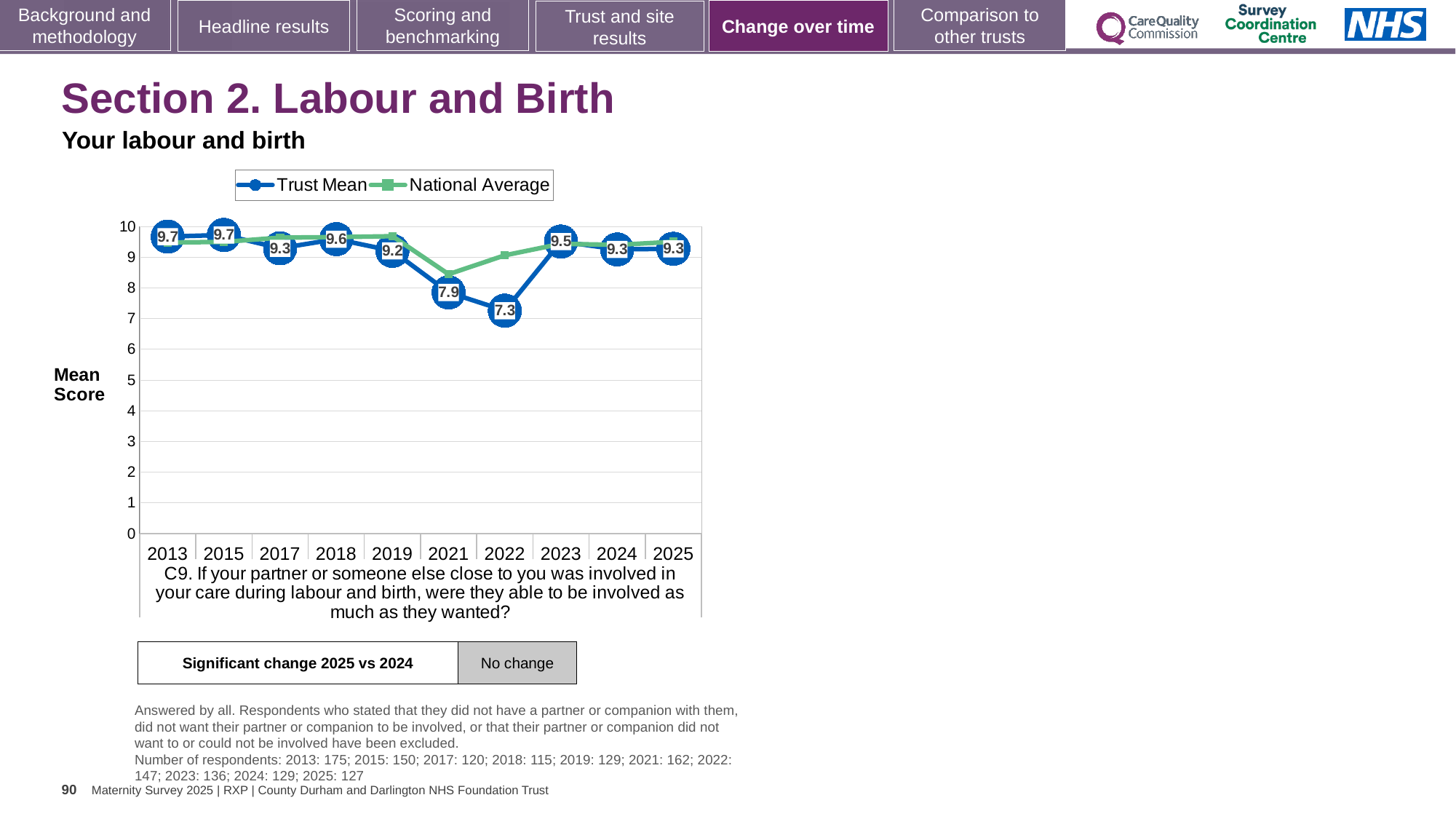
Which is larger, the Trust Mean for 2018 or for 2019? 2018 What is the Trust Mean value for 2025? 9.3 What is the Trust Mean value for 2018? 9.6 What is the Trust Mean value for 2022? 7.3 Is the National Average value for 2021 greater or less than 8? greater What kind of chart is shown on the slide? Line chart What is the Trust Mean value for 2021? 7.9 How many series does the legend list? 2 Does the Trust Mean rise or fall from 2022 to 2023? Rise How many years are shown on the x axis? 10 In which year is the Trust Mean lowest? 2022 What is the difference between the Trust Mean in 2021 and in 2022? 0.6